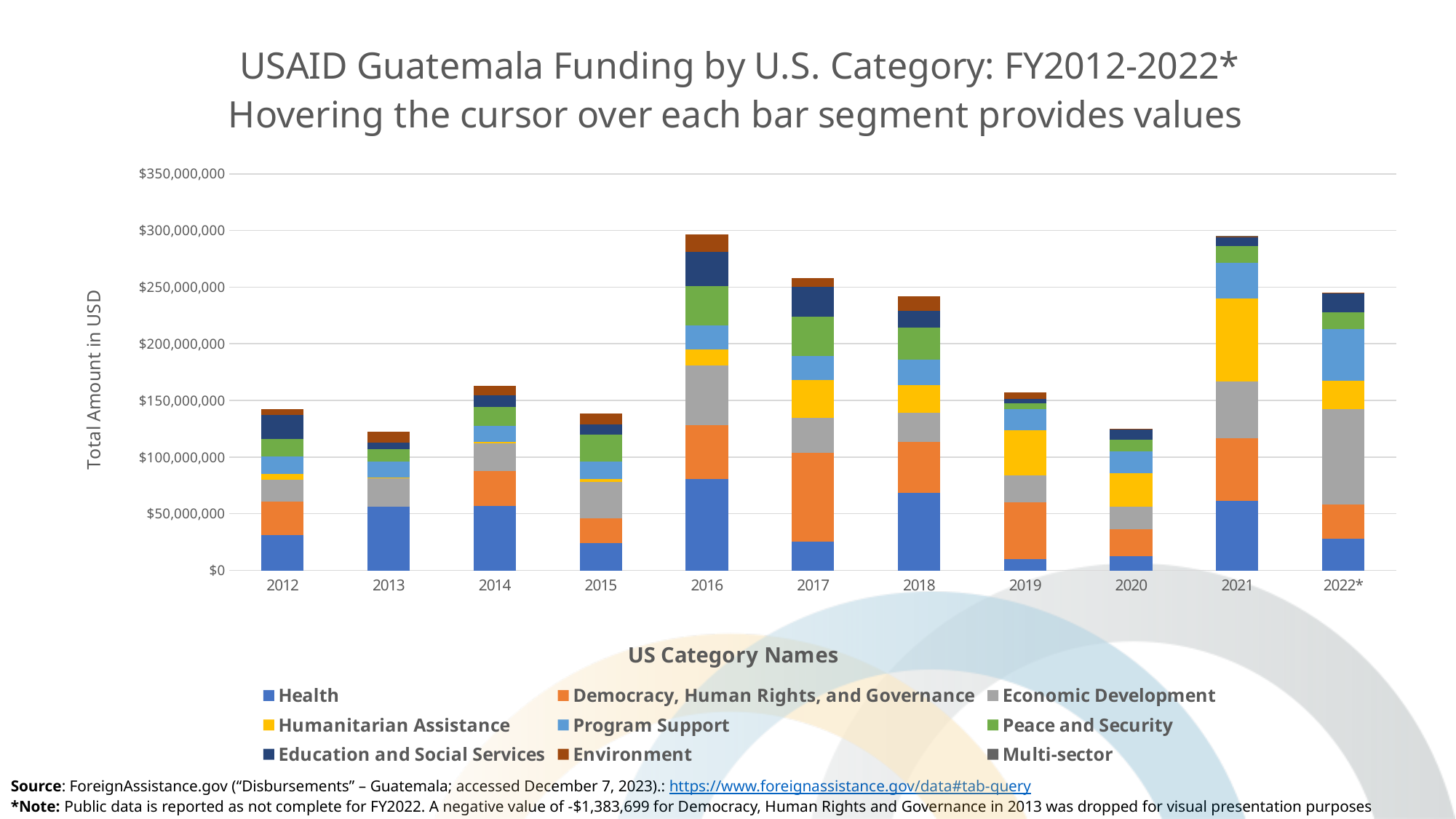
Which year has the larger total bar, 2016 or 2013? 2016 Is the total bar height for 2015 greater or less than $150,000,000? less What kind of chart is shown on the slide? Stacked bar chart How many categories does the legend list? 9 Do the total bar heights rise or fall from 2016 through 2020? fall What is the label on the y axis of the chart? Total Amount in USD Which year has the larger Health segment, 2016 or 2012? 2016 Which year has the larger Humanitarian Assistance segment, 2021 or 2019? 2021 Is the total bar height for 2018 greater or less than $200,000,000? greater Is the total bar height for 2020 greater or less than $150,000,000? less How many fiscal years are shown along the x axis? 11